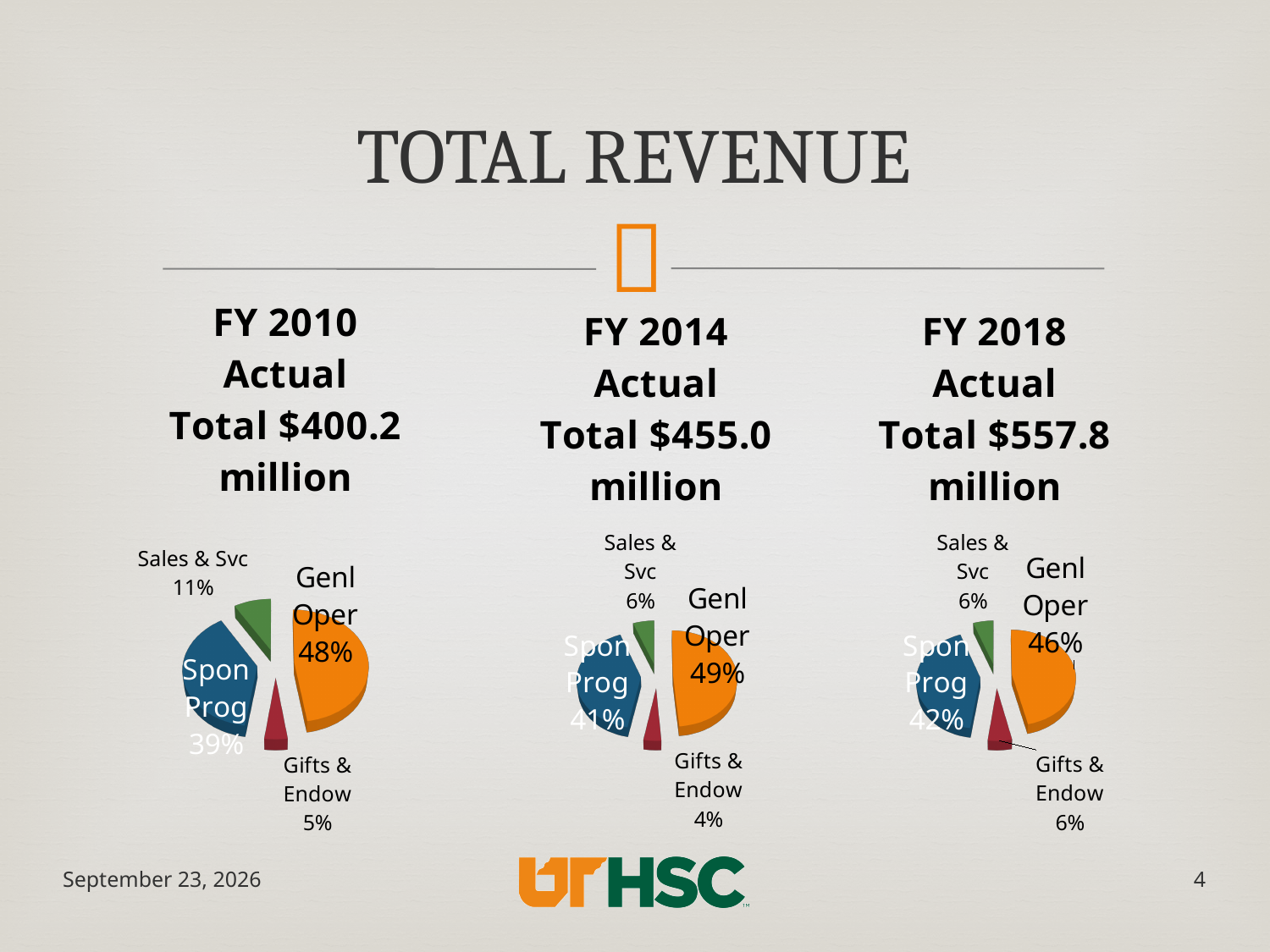
In the FY 2010 Actual pie chart, what share does Genl Oper have? 48% In the FY 2018 Actual pie chart, what is the difference between the Genl Oper share and the Spon Prog share? 4% In the FY 2014 Actual pie chart, what share does Sales & Svc have? 6% What is the total revenue stated above the FY 2018 Actual pie chart? $557.8 million In the FY 2014 Actual pie chart, which category has the smallest share? Gifts & Endow In the FY 2018 Actual pie chart, what share does Gifts & Endow have? 6% In the FY 2010 Actual pie chart, which is larger, Sales & Svc or Gifts & Endow? Sales & Svc In the FY 2010 Actual pie chart, which category has the largest share? Genl Oper In the FY 2014 Actual pie chart, what share does Spon Prog have? 41% How many pie charts are shown on the slide? 3 What kind of chart is used to show the FY 2018 Actual revenue breakdown? Pie chart How many slices does the FY 2014 Actual pie chart have? 4